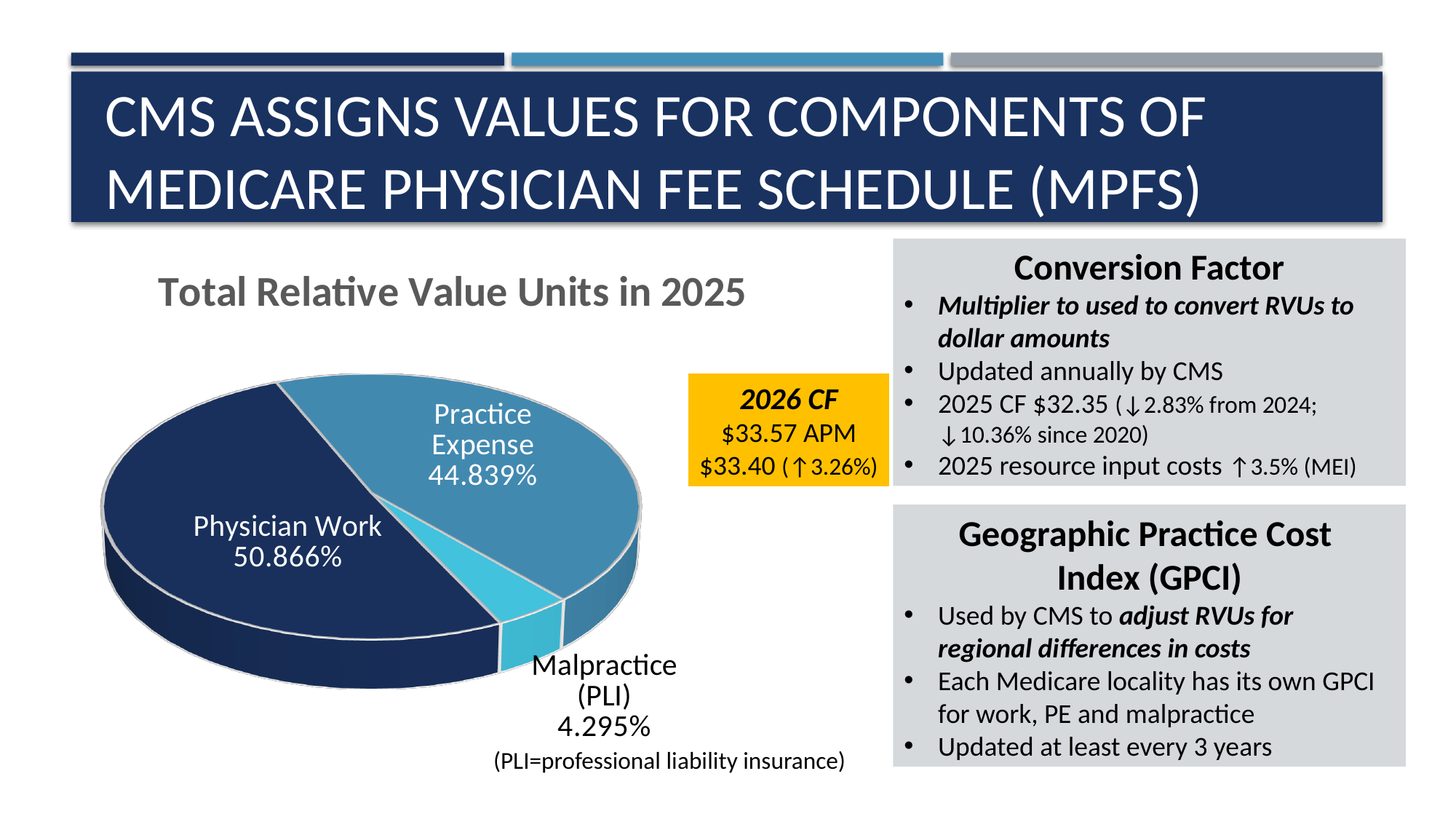
What share of the pie does Physician Work represent? 50.866% Which component has the smallest share of the pie? Malpractice (PLI) What share of the pie does Malpractice (PLI) represent? 4.295% What is the difference in percentage points between the Physician Work share and the Practice Expense share? 6.027 Which is larger, the share for Physician Work or the share for Practice Expense? Physician Work Which component has the largest share of the pie? Physician Work What does PLI stand for, according to the note under the chart? Professional liability insurance What is the difference in percentage points between the Practice Expense share and the Malpractice (PLI) share? 40.544 What kind of chart is shown on the slide? Pie chart What share of the pie does Practice Expense represent? 44.839% What is the title of the chart? Total Relative Value Units in 2025 How many slices does the pie chart have? 3